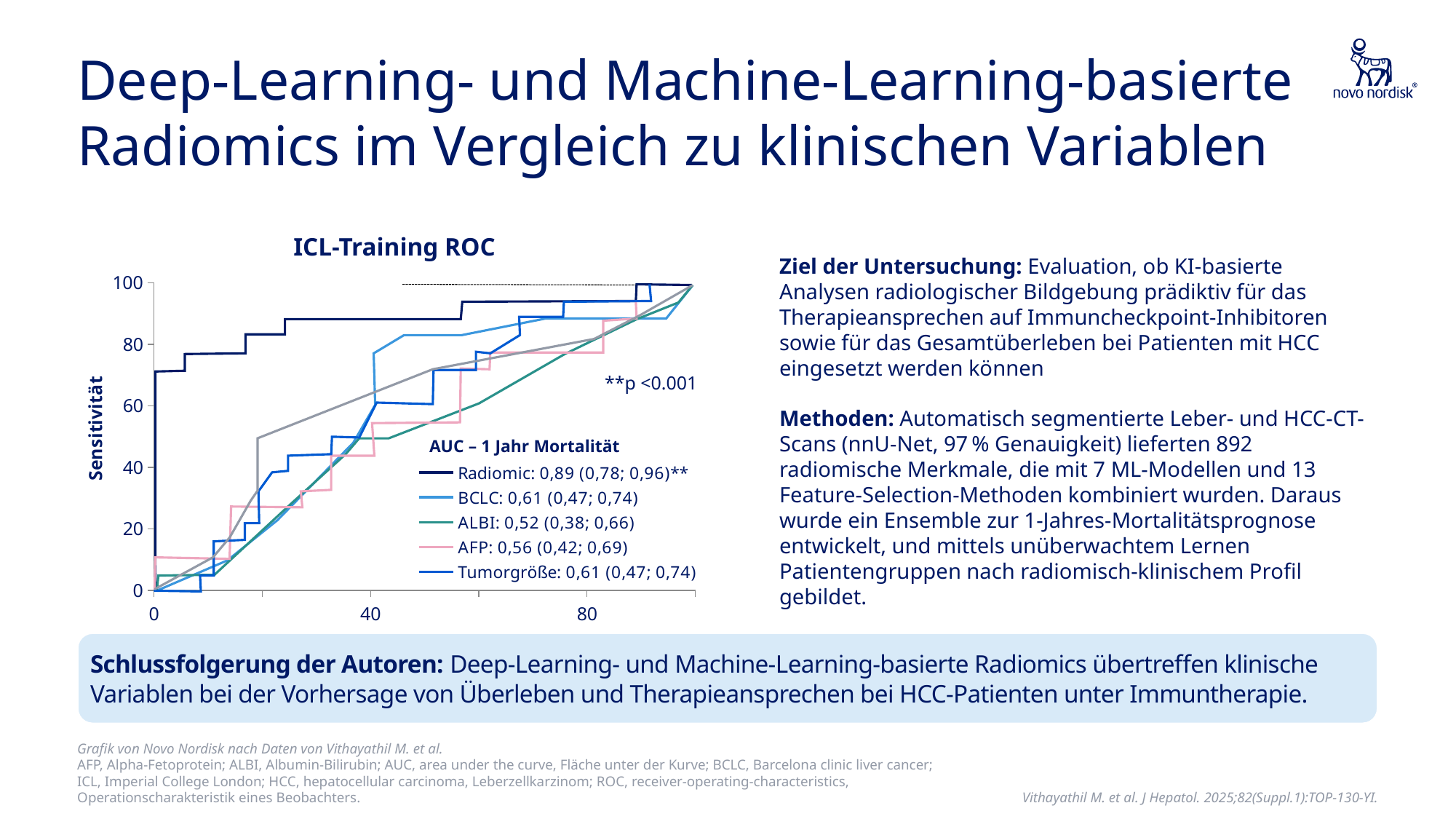
Which series has the lowest AUC according to the legend? ALBI Is the sensitivity of the Radiomic curve at x = 40 greater or less than 80? greater What is the difference between the AUC of Radiomic and the AUC of ALBI? 0,37 How many series does the chart legend list? 5 Which has the larger AUC, AFP or ALBI? AFP What is the title of the chart? ICL-Training ROC Which series has the highest AUC according to the legend? Radiomic What is the label of the y axis? Sensitivität What AUC value is given for ALBI in the legend? 0,52 (0,38; 0,66) What AUC value is given for Radiomic in the legend? 0,89 (0,78; 0,96)** What type of chart is shown on the slide? line chart What AUC value is given for AFP in the legend? 0,56 (0,42; 0,69)